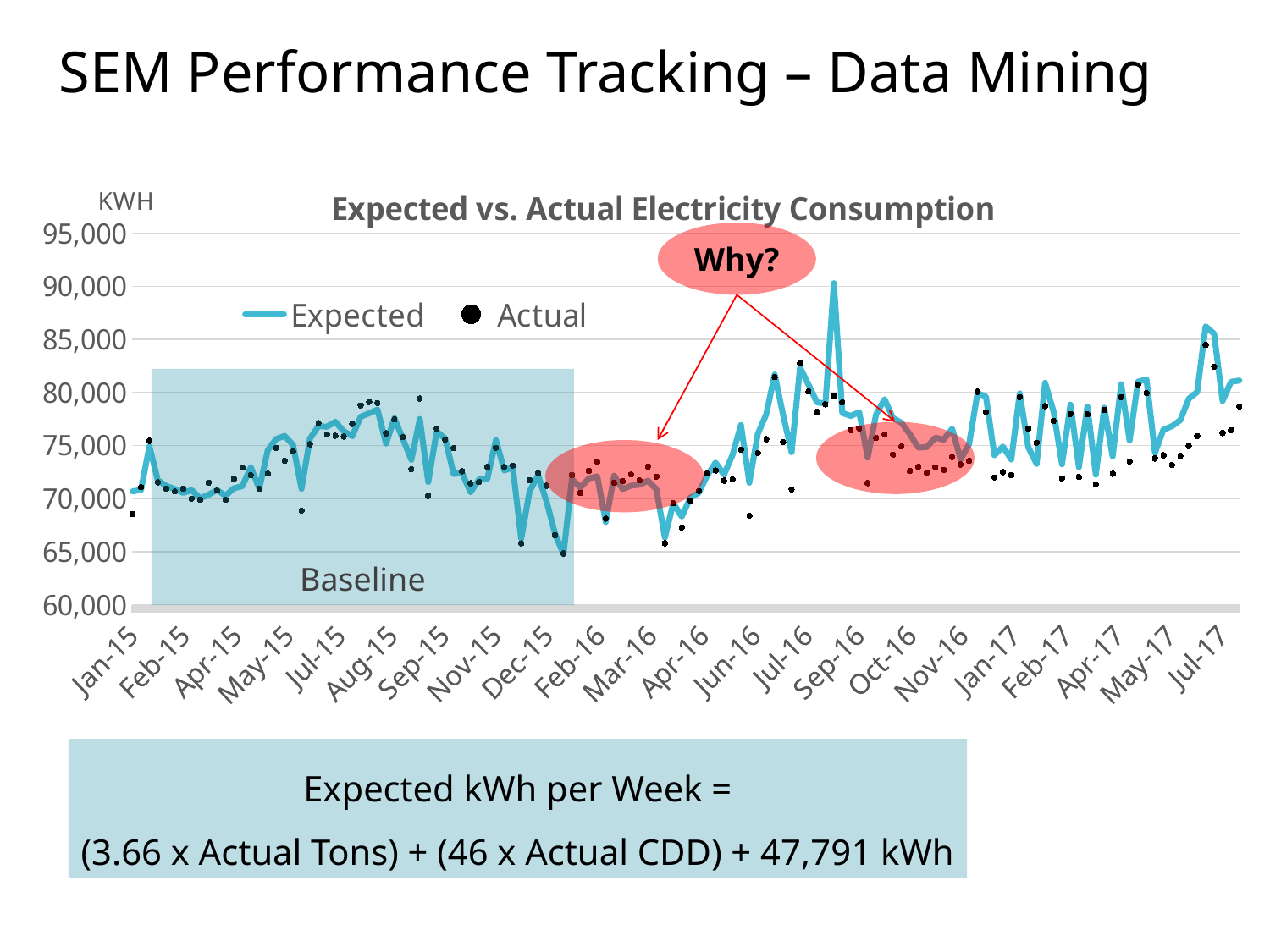
Does the Expected series rise or fall from Jan-15 to Jul-15? rise What kind of chart is shown on the slide? line chart Is the Expected value at Jul-15 greater or less than 75,000? greater What unit is shown at the top of the vertical axis? KWH Which series is drawn as a solid line rather than dots? Expected What is the title of the chart? Expected vs. Actual Electricity Consumption Is the lowest value of the Expected series around Dec-15 greater or less than 70,000? less How many month labels are shown along the x axis? 22 How many series does the chart's legend list? 2 Is the dip in the Expected series around Mar-16 greater or less than 70,000? less Does the Expected series rise or fall from its peak around Aug-16 to Nov-16? fall